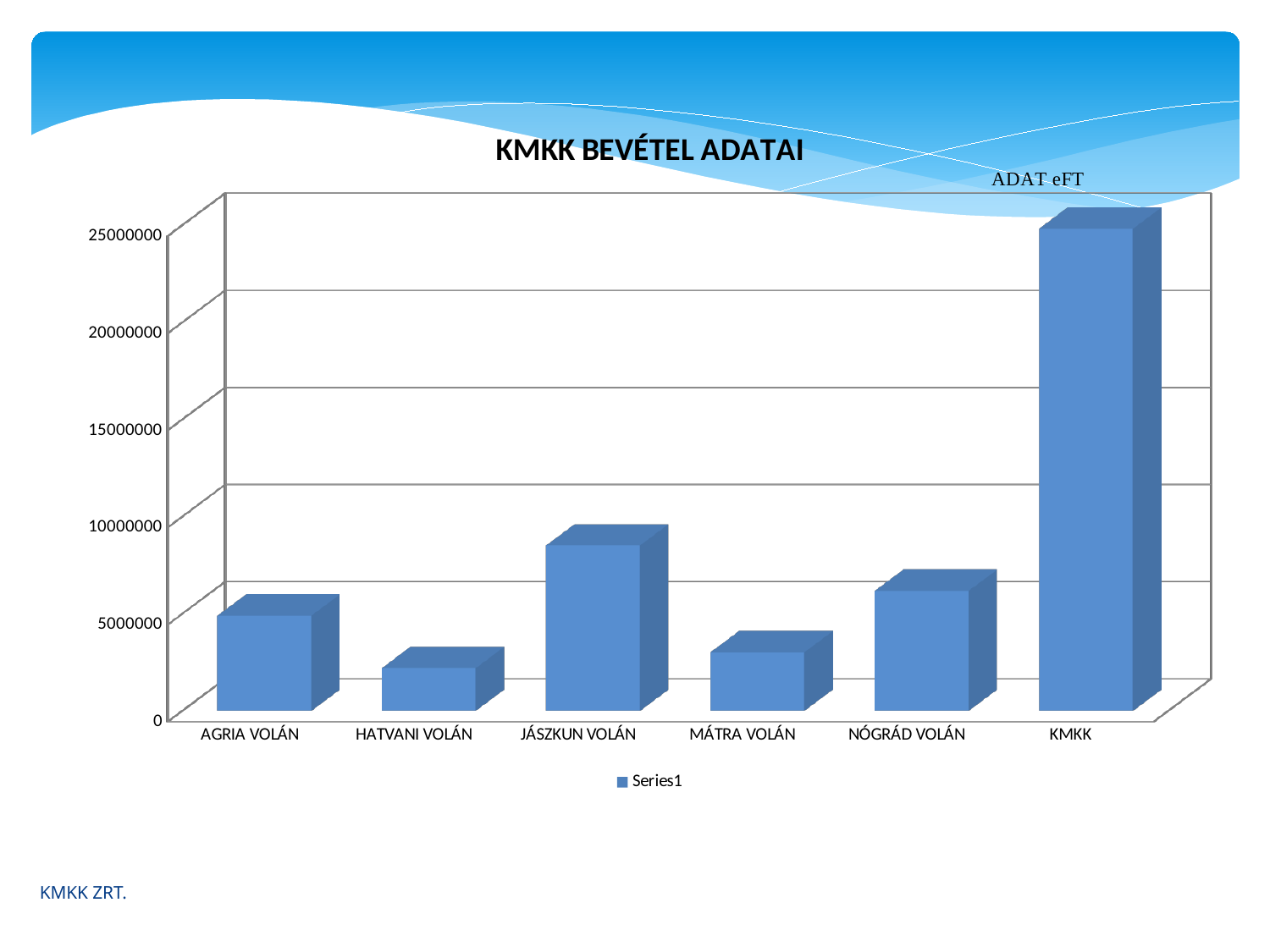
Is the value for HATVANI VOLÁN greater or less than 5000000? less Which has the larger value, JÁSZKUN VOLÁN or NÓGRÁD VOLÁN? JÁSZKUN VOLÁN Which category has the highest value in the chart? KMKK What is the name of the series shown in the legend? Series1 What is the title of the chart? KMKK BEVÉTEL ADATAI Is the value for JÁSZKUN VOLÁN greater or less than 10000000? less Which has the larger value, AGRIA VOLÁN or HATVANI VOLÁN? AGRIA VOLÁN How many categories are shown on the x axis of the chart? 6 Which category has the lowest value in the chart? HATVANI VOLÁN Is the value for KMKK greater or less than 20000000? greater What kind of chart is shown on the slide? bar chart How many series does the chart legend list? 1